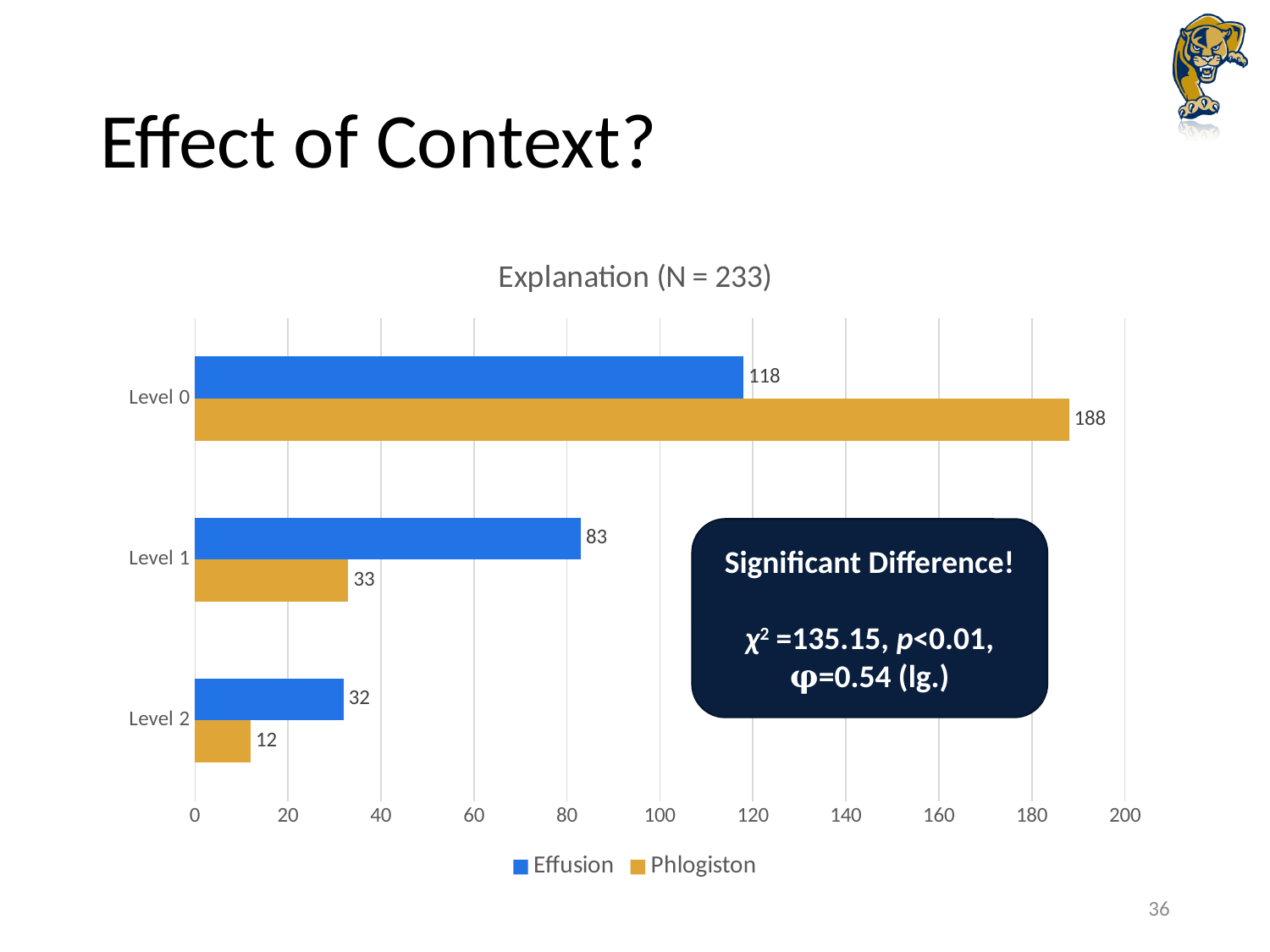
What is the Phlogiston value for Level 2? 12 How many levels (categories) are shown on the chart? 3 What is the Effusion value for Level 0? 118 Which level has the lowest Effusion value? Level 2 What kind of chart is shown on the slide? Bar chart How many series does the legend list? 2 What is the Phlogiston value for Level 1? 33 What is the title of the chart? Explanation (N = 233) Which level has the highest Phlogiston value? Level 0 What is the difference between the Phlogiston and Effusion values for Level 0? 70 What is the difference between the Effusion and Phlogiston values for Level 1? 50 For Level 2, which series has the larger value, Effusion or Phlogiston? Effusion